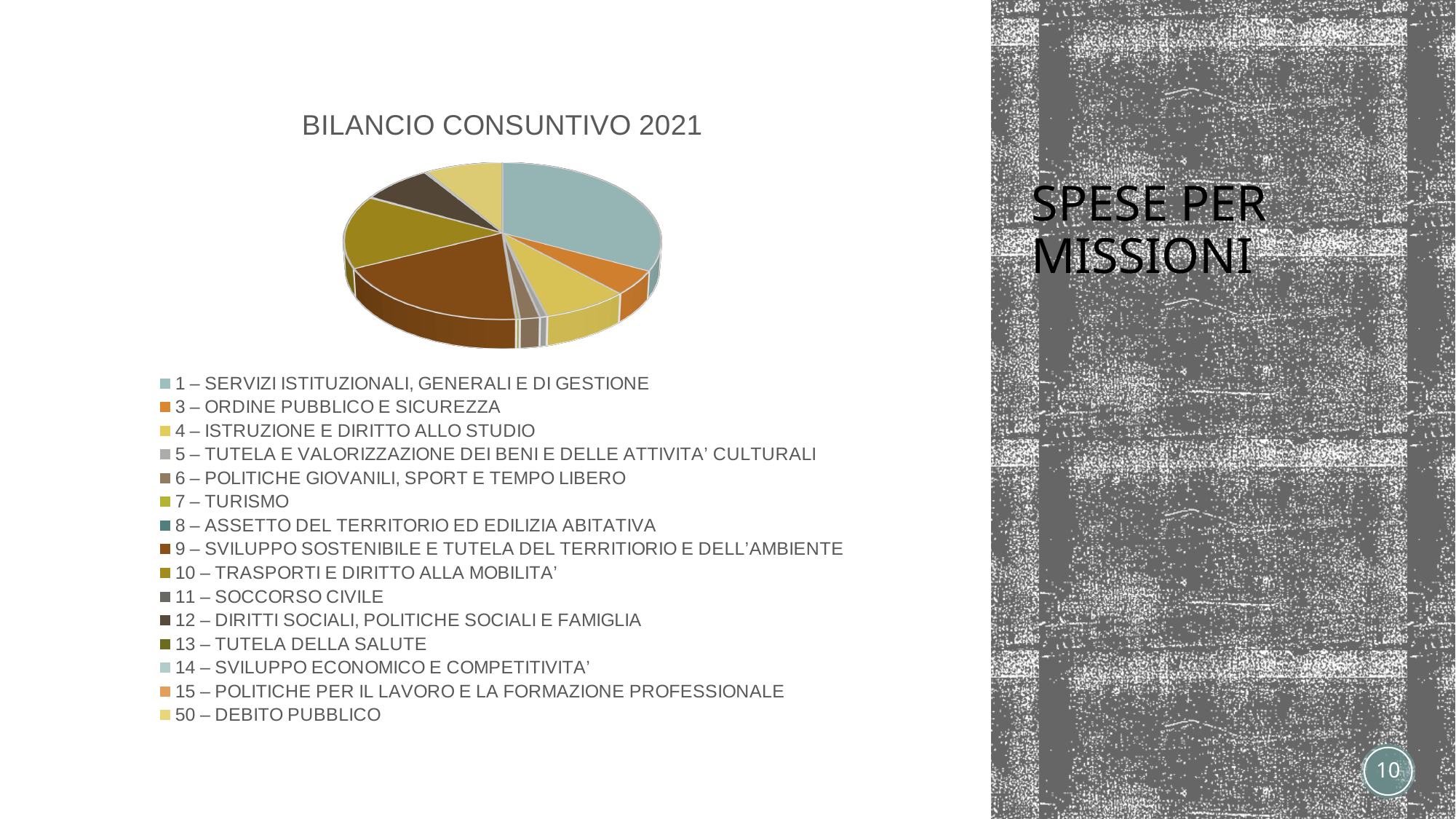
Which slice is larger: 4 – ISTRUZIONE E DIRITTO ALLO STUDIO or 6 – POLITICHE GIOVANILI, SPORT E TEMPO LIBERO? 4 – ISTRUZIONE E DIRITTO ALLO STUDIO What is the title of the chart? BILANCIO CONSUNTIVO 2021 What is the legend label for category number 50? 50 – DEBITO PUBBLICO Which slice is larger: 10 – TRASPORTI E DIRITTO ALLA MOBILITA' or 5 – TUTELA E VALORIZZAZIONE DEI BENI E DELLE ATTIVITA' CULTURALI? 10 – TRASPORTI E DIRITTO ALLA MOBILITA' Which slice is larger: 1 – SERVIZI ISTITUZIONALI, GENERALI E DI GESTIONE or 3 – ORDINE PUBBLICO E SICUREZZA? 1 – SERVIZI ISTITUZIONALI, GENERALI E DI GESTIONE How many categories does the chart's legend list? 15 What kind of chart is shown on the slide? pie chart